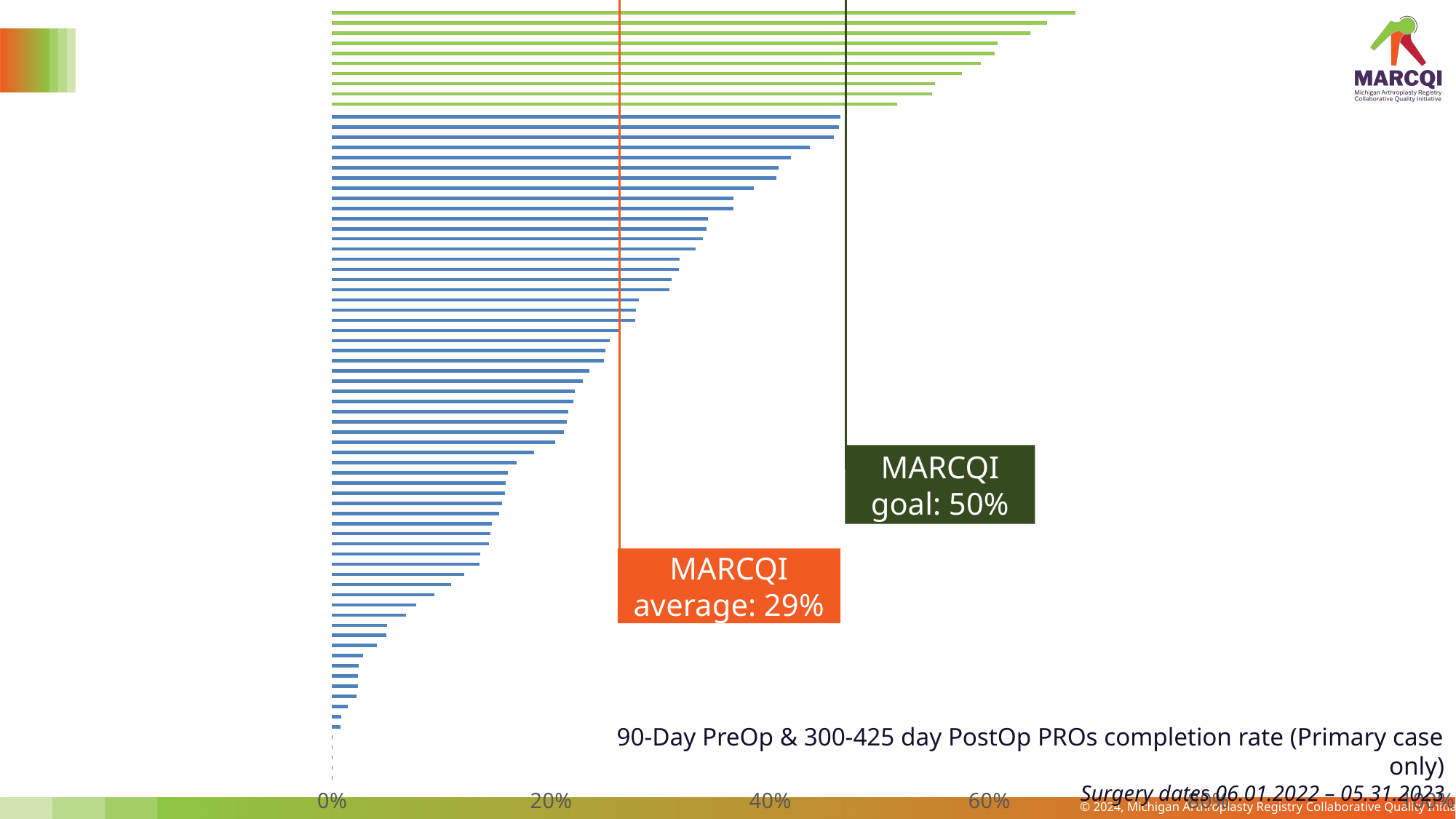
What is the MARCQI average completion rate shown on the chart? 29% Is the value of the longest bar greater or less than 60%? greater What is the MARCQI goal completion rate shown on the chart? 50% Which is larger, the MARCQI goal or the MARCQI average? MARCQI goal What colour are the bars that exceed the MARCQI goal? green Is the value of the shortest bar greater or less than 20%? less Do the bars get longer or shorter going from the top of the chart to the bottom? shorter What is the title of the chart? 90-Day PreOp & 300-425 day PostOp PROs completion rate (Primary case only) What kind of chart is shown on the slide? bar chart What is the difference between the MARCQI goal and the MARCQI average? 21 percentage points Is the value of the longest blue bar greater or less than 50%? less